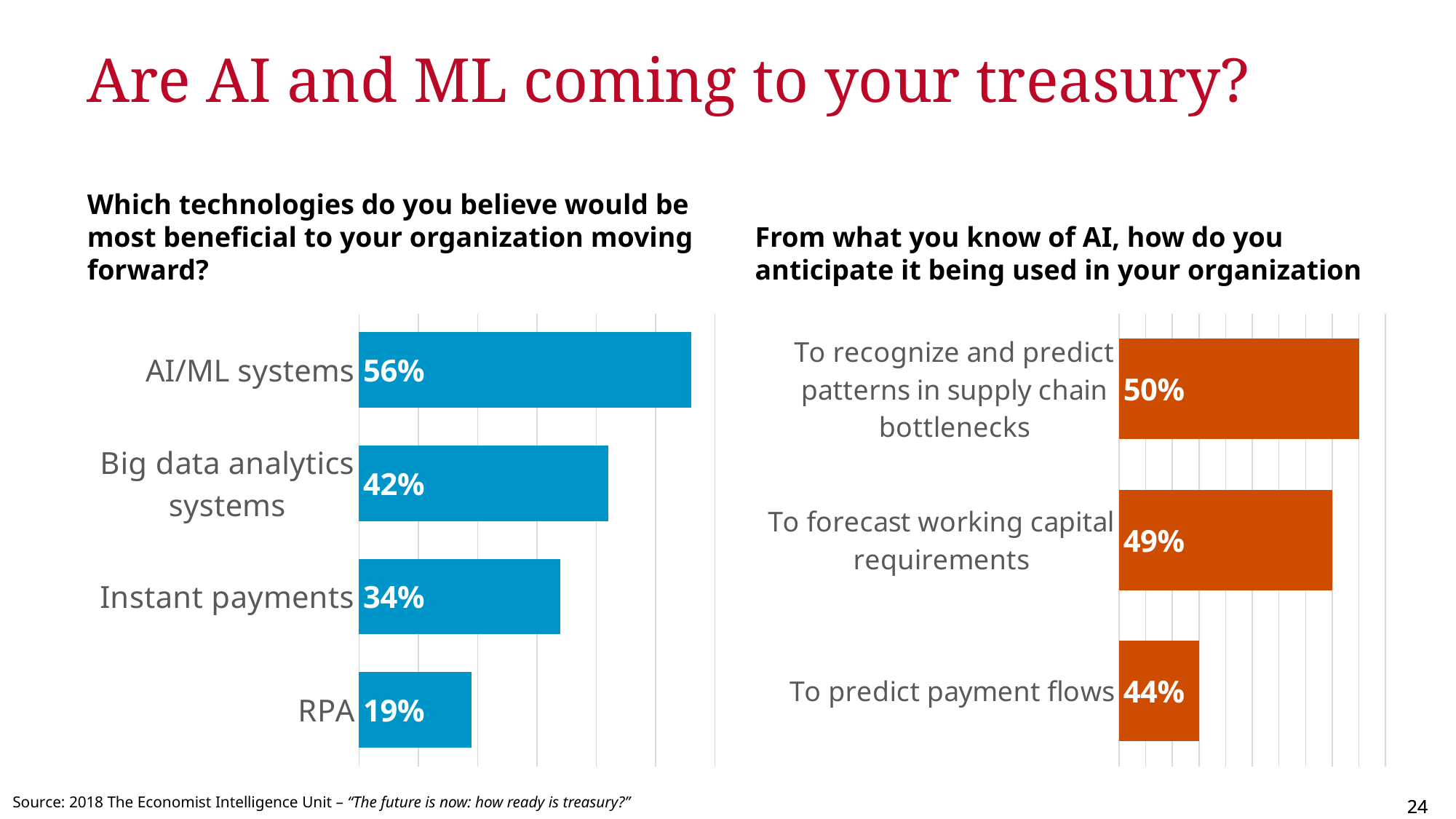
In the left chart (Which technologies do you believe would be most beneficial), which category has the lowest value? RPA What colour are the bars in the left chart (Which technologies do you believe would be most beneficial)? Blue In the left chart (Which technologies do you believe would be most beneficial), what is the value for RPA? 19% In the right chart (From what you know of AI, how do you anticipate it being used), what is the difference between To recognize and predict patterns in supply chain bottlenecks and To predict payment flows? 6% In the left chart (Which technologies do you believe would be most beneficial), what is the difference between AI/ML systems and Big data analytics systems? 14% In the left chart (Which technologies do you believe would be most beneficial), which is larger: Instant payments or Big data analytics systems? Big data analytics systems What type of chart is the right chart (From what you know of AI, how do you anticipate it being used)? Bar chart In the right chart (From what you know of AI, how do you anticipate it being used), what is the value for To forecast working capital requirements? 49% In the left chart (Which technologies do you believe would be most beneficial), how many categories are shown? 4 In the left chart (Which technologies do you believe would be most beneficial), what is the value for AI/ML systems? 56% In the right chart (From what you know of AI, how do you anticipate it being used), how many categories are shown? 3 In the right chart (From what you know of AI, how do you anticipate it being used), which category has the highest value? To recognize and predict patterns in supply chain bottlenecks